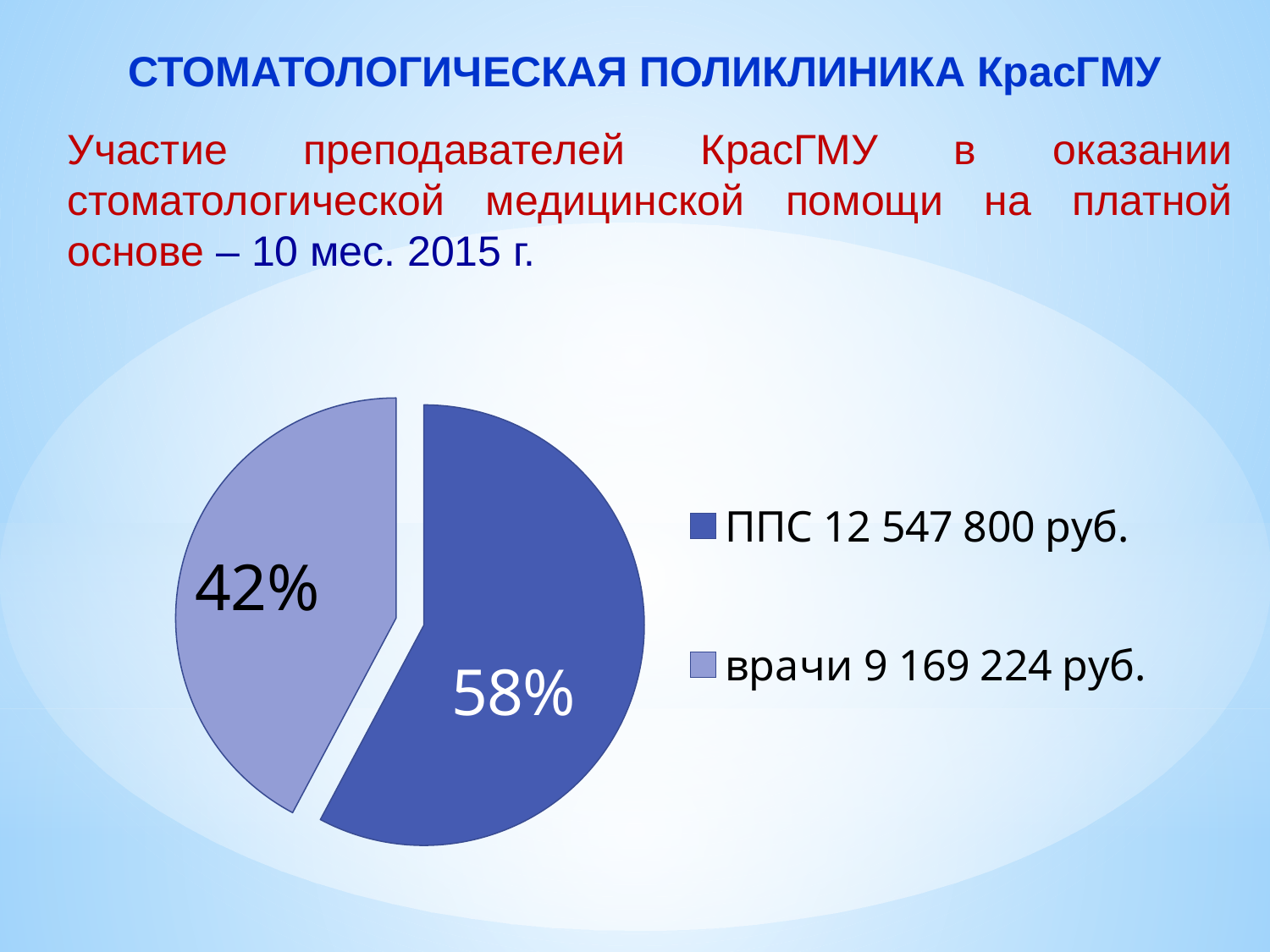
Which slice of the pie is the smallest? врачи Which legend entry is shown in the lighter blue colour? врачи 9 169 224 руб. How many entries does the legend list? 2 What share of the pie does the врачи slice represent? 42% What is the difference in percentage points between the ППС slice and the врачи slice? 16 Which slice of the pie is the largest? ППС How many slices does the pie chart have? 2 What share of the pie does the ППС slice represent? 58% What ruble amount is shown in the legend for врачи? 9 169 224 руб. What type of chart is shown on the slide? pie chart Which is larger, the ППС slice or the врачи slice? ППС What ruble amount is shown in the legend for ППС? 12 547 800 руб.